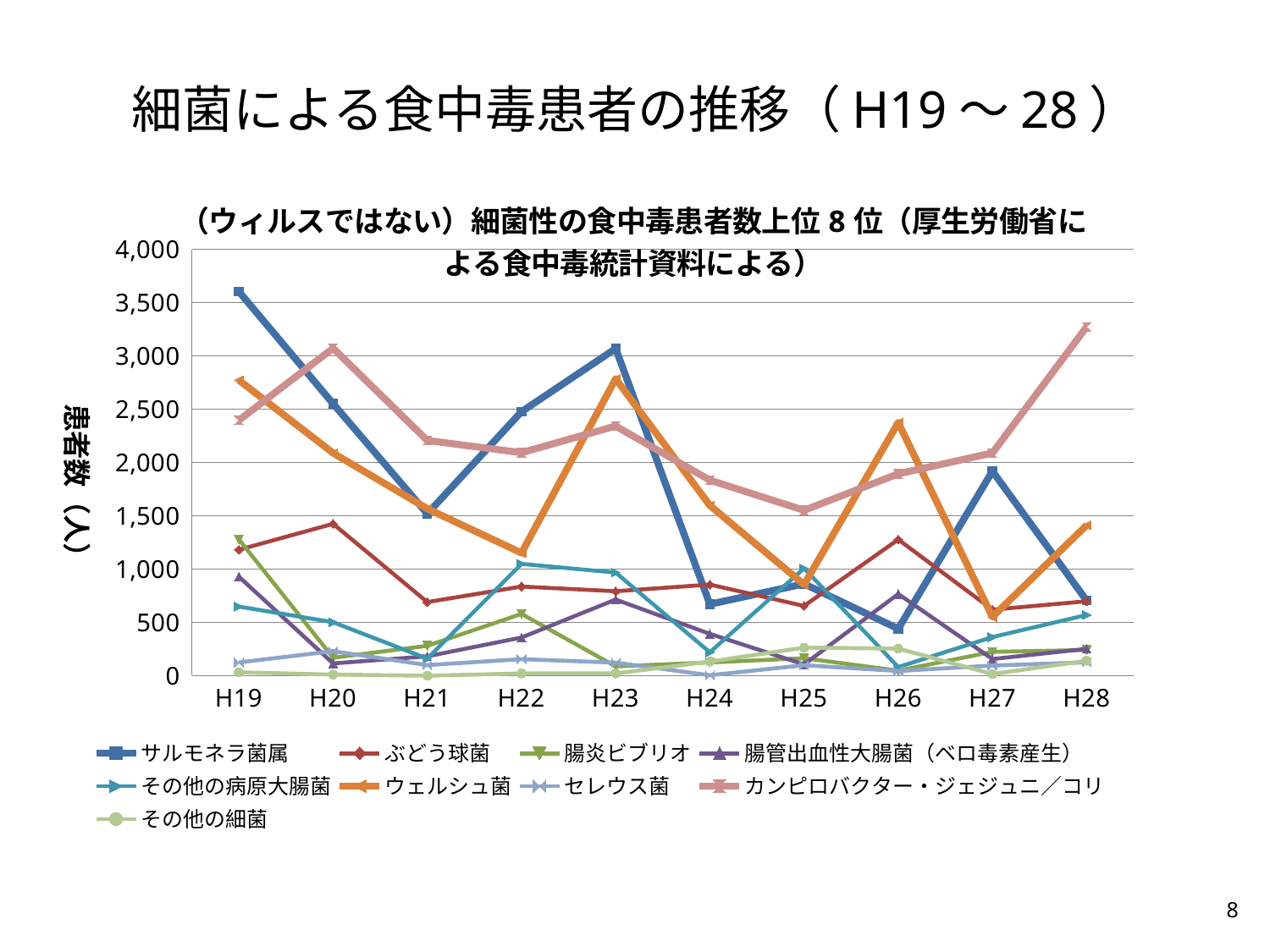
Is the value for サルモネラ菌属 in H26 greater or less than 1,000? less How many series does the legend list? 9 Is the value for サルモネラ菌属 in H19 greater or less than 3,000? greater What is the label of the y axis? 患者数（人） Is the value for ウェルシュ菌 in H23 greater or less than 2,500? greater In which year does サルモネラ菌属 reach its highest value? H19 How many years (categories) are plotted along the x axis? 10 In H20, which is larger: サルモネラ菌属 or カンピロバクター・ジェジュニ／コリ? カンピロバクター・ジェジュニ／コリ Which series has the highest value in H28? カンピロバクター・ジェジュニ／コリ Does the value for サルモネラ菌属 rise or fall from H19 to H21? fall What kind of chart is shown on the slide? line chart